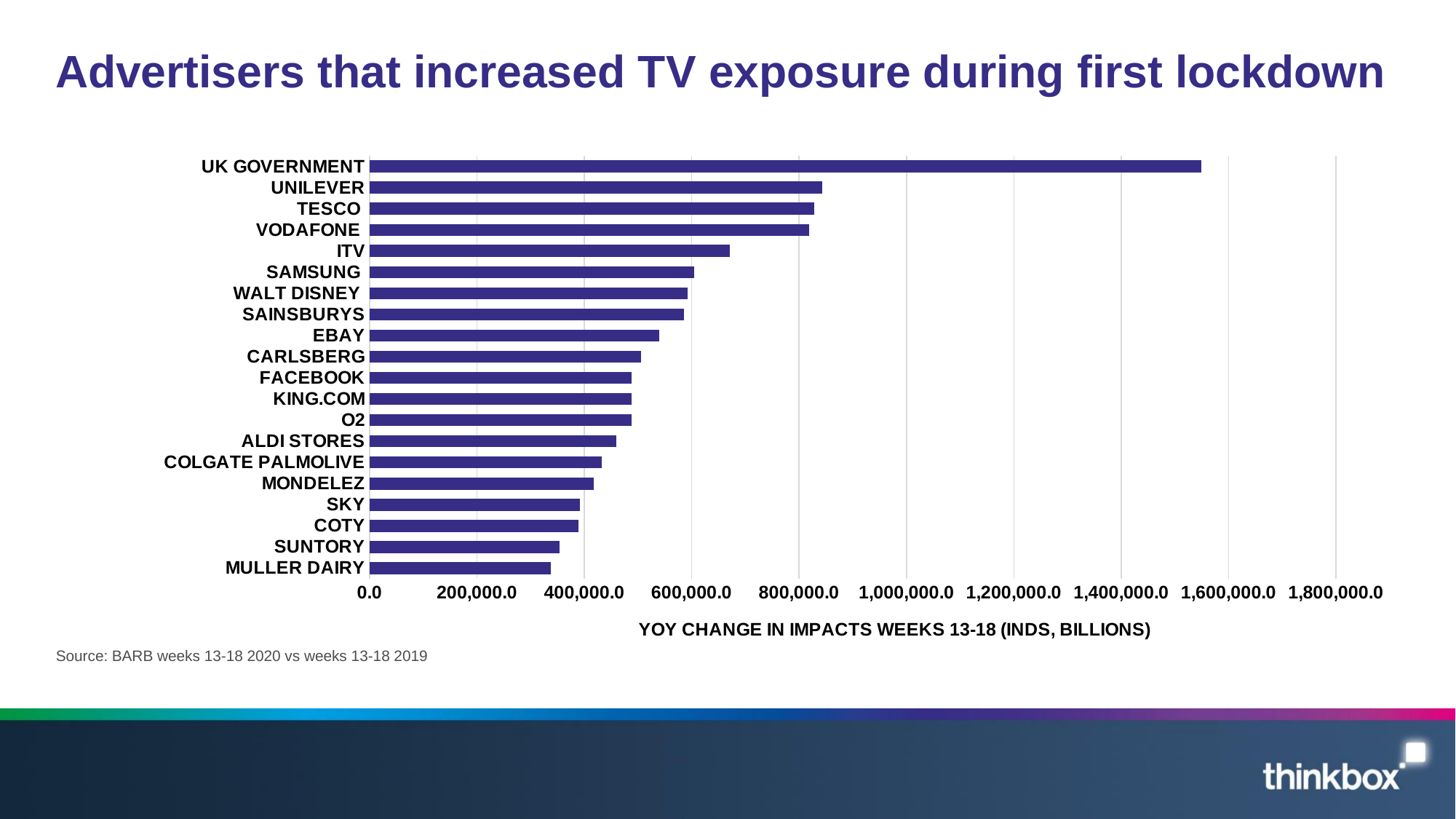
Which has the larger YOY change in impacts, MONDELEZ or UNILEVER? UNILEVER Which has the larger YOY change in impacts, ITV or EBAY? ITV What kind of chart is shown on the slide? bar chart Is the value for UNILEVER greater or less than 800,000.0? greater Is the value for SUNTORY greater or less than 400,000.0? less What is the title of the horizontal axis? YOY CHANGE IN IMPACTS WEEKS 13-18 (INDS, BILLIONS) Is the value for ALDI STORES greater or less than 400,000.0? greater How many advertisers are listed on the chart? 20 Which advertiser has the largest YOY change in impacts? UK GOVERNMENT